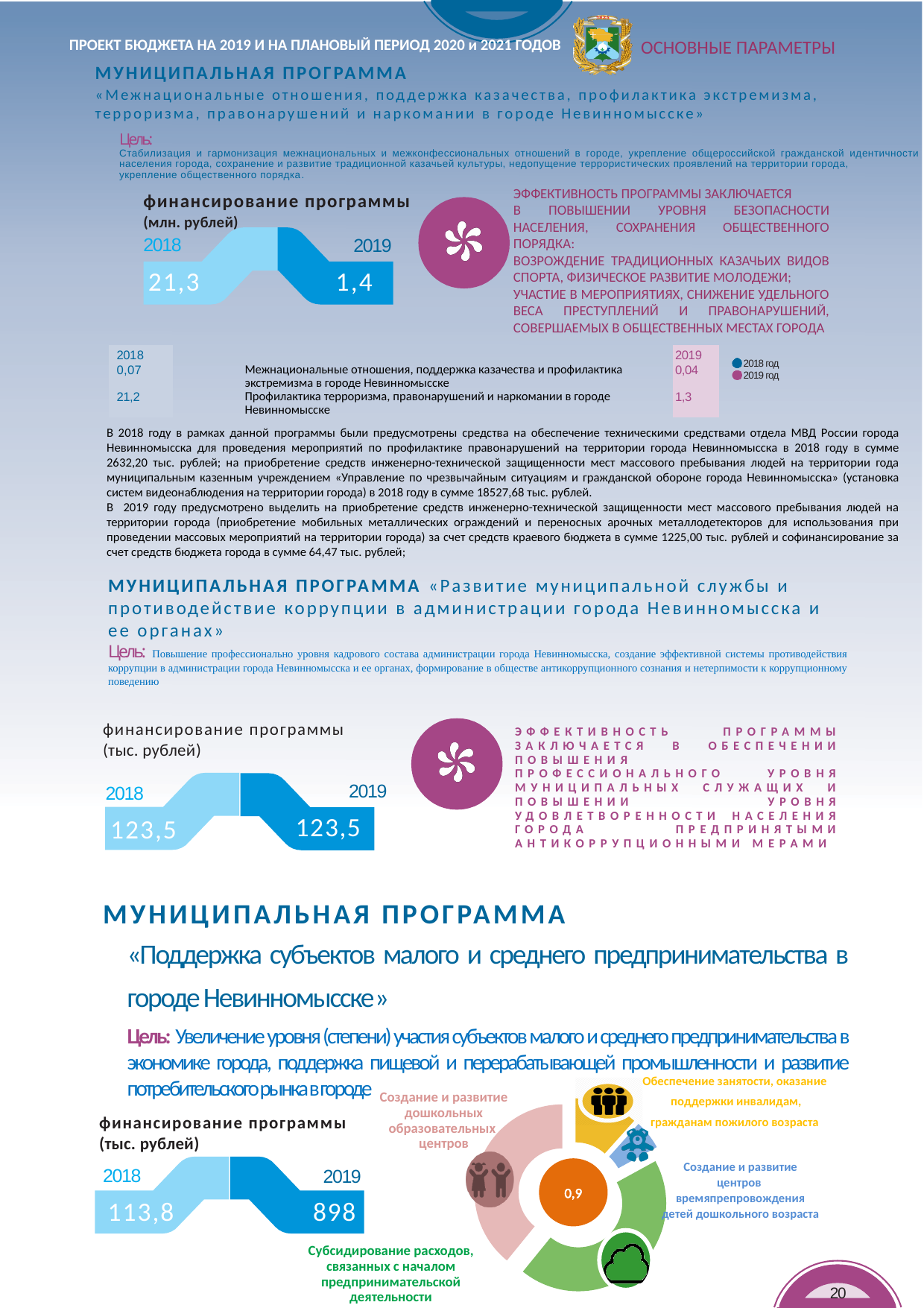
In the bar chart below the first program's financing, which category has the higher 2019 value? Профилактика терроризма, правонарушений и наркомании в городе Невинномысске In the ring chart at the bottom right of the slide, how many labelled segments are there? 4 In the 'финансирование программы (тыс. рублей)' chart for the third program (support of small and medium business), what is the value for 2018? 113,8 In the bar chart below the first program's financing, how many categories are shown? 2 In the bar chart below the first program's financing, what is the 2018 value for 'Профилактика терроризма, правонарушений и наркомании в городе Невинномысске'? 21,2 In the bar chart below the first program's financing (with legend '2018 год' and '2019 год'), how many series does the legend list? 2 In the first 'финансирование программы (млн. рублей)' chart at the top of the slide, what is the value for 2018? 21,3 In the first 'финансирование программы (млн. рублей)' chart at the top of the slide, what is the value for 2019? 1,4 In the bar chart below the first program's financing, what is the 2019 value for 'Межнациональные отношения, поддержка казачества и профилактика экстремизма в городе Невинномысске'? 0,04 In the 'финансирование программы (тыс. рублей)' chart for the second program (municipal service and anti-corruption), what is the value for 2019? 123,5 In the first 'финансирование программы (млн. рублей)' chart at the top of the slide, by how much does the 2018 value exceed the 2019 value? 19,9 In the 'финансирование программы (тыс. рублей)' chart for the third program (support of small and medium business), which year has the larger value, 2018 or 2019? 2019